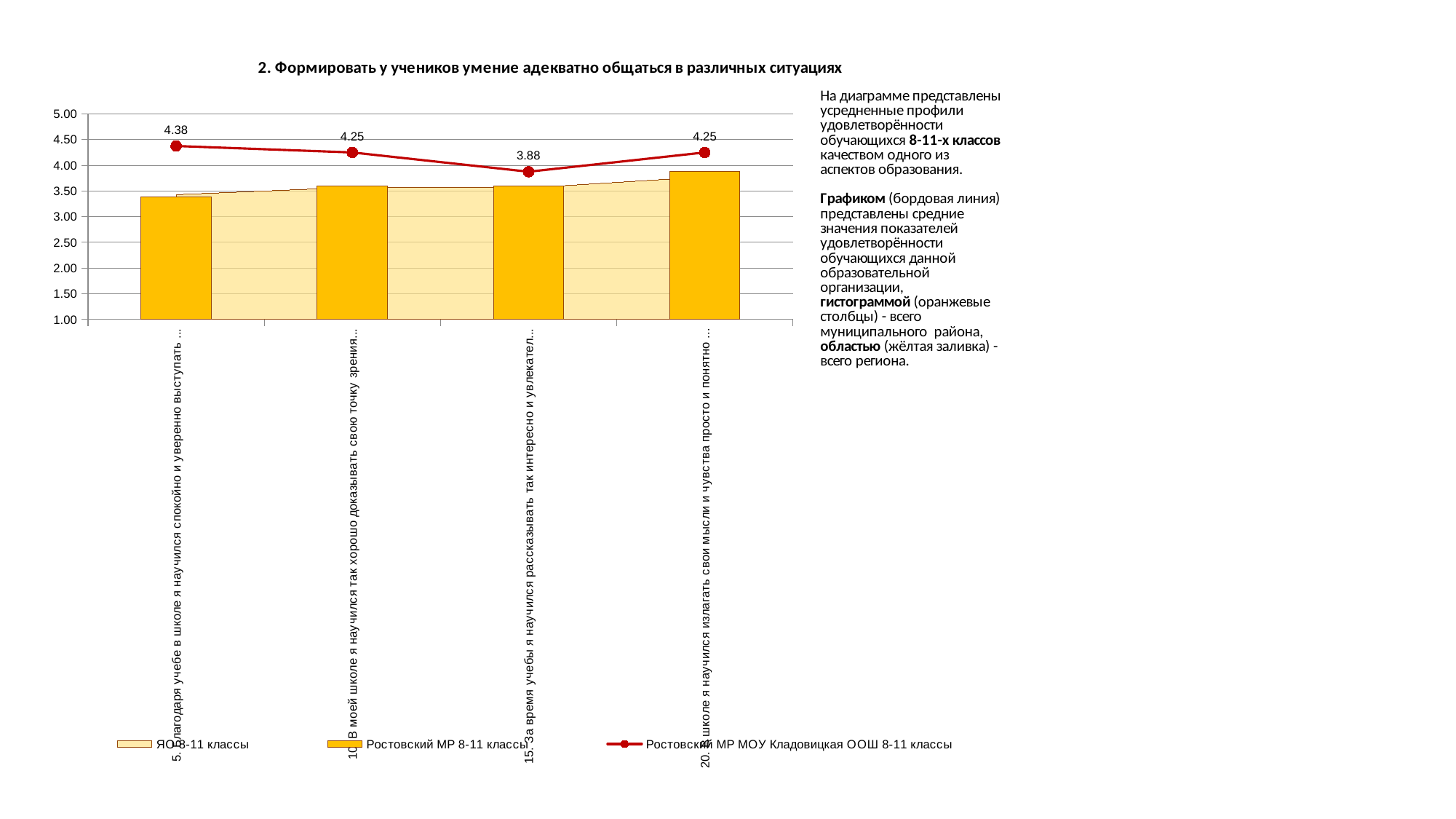
What is the value of the Ростовский МР МОУ Кладовицкая ООШ 8-11 классы line for category 15? 3.88 Which has the larger line value, category 10 or category 15? 10 For which category is the Ростовский МР МОУ Кладовицкая ООШ 8-11 классы line highest? 5 What is the value of the Ростовский МР МОУ Кладовицкая ООШ 8-11 классы line for category 20? 4.25 What is the value of the Ростовский МР МОУ Кладовицкая ООШ 8-11 классы line for category 5? 4.38 How many categories are shown on the x axis? 4 Is the Ростовский МР 8-11 классы bar for category 5 greater or less than 3.50? less How many series does the legend list? 3 Does the Ростовский МР МОУ Кладовицкая ООШ 8-11 классы line rise or fall from category 5 to category 15? fall Is the Ростовский МР 8-11 классы bar for category 20 greater or less than 3.50? greater For which category is the Ростовский МР МОУ Кладовицкая ООШ 8-11 классы line lowest? 15 What is the difference between the line values for category 5 and category 15? 0.50